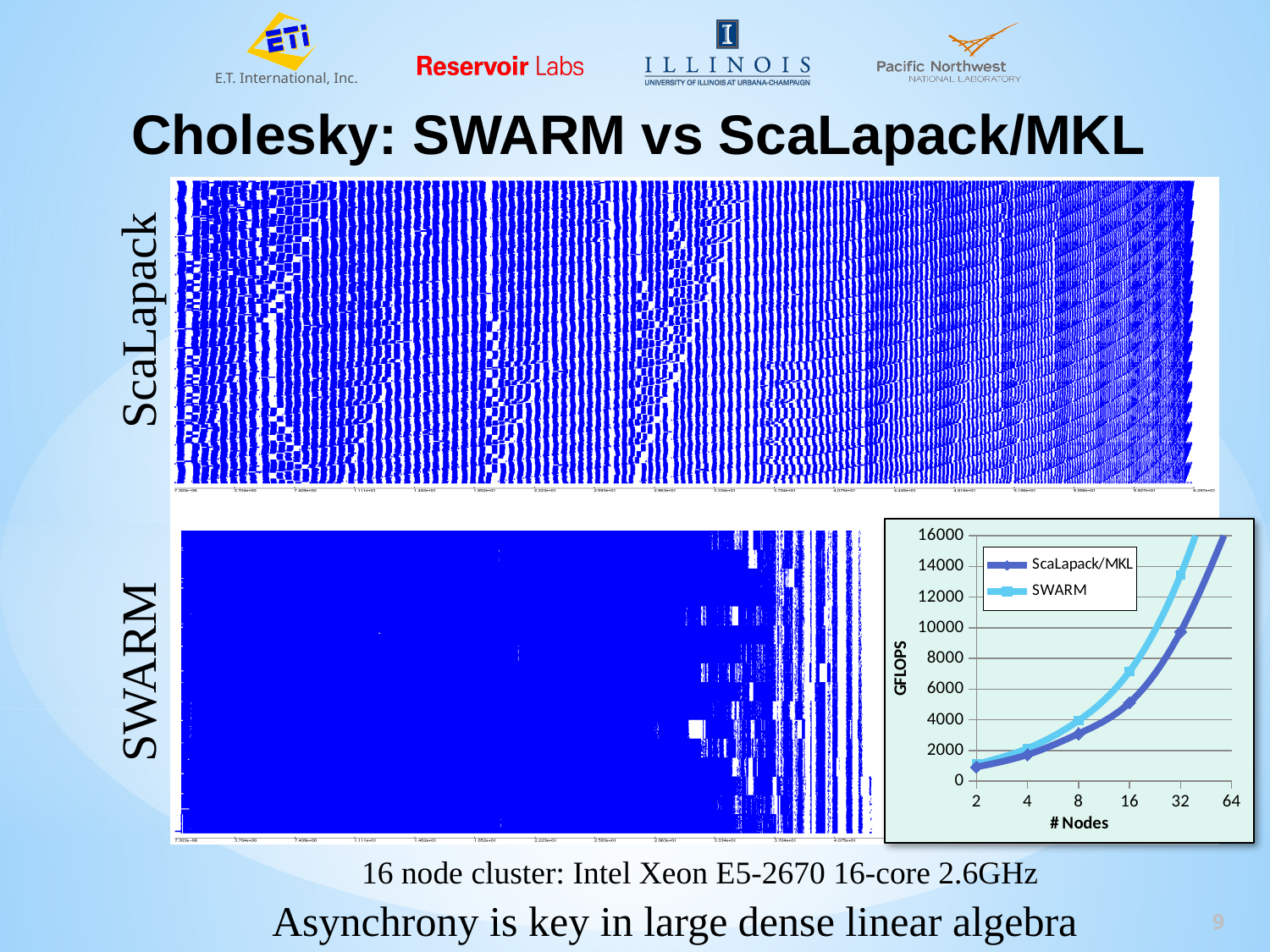
What is the label of the vertical axis of the line chart? GFLOPS In the GFLOPS chart, is the ScaLapack/MKL value at 32 nodes greater or less than 8000? greater How many node counts are marked on the x axis of the GFLOPS chart? 6 In the GFLOPS chart, do the values rise or fall as the number of nodes increases? rise In the GFLOPS chart, is the SWARM value at 2 nodes greater or less than 2000? less In the GFLOPS chart, which series is higher at 16 nodes, SWARM or ScaLapack/MKL? SWARM In the GFLOPS chart, is the ScaLapack/MKL value at 8 nodes greater or less than 4000? less Which two series are listed in the legend of the GFLOPS chart? ScaLapack/MKL and SWARM How many series does the legend of the GFLOPS chart list? 2 In the GFLOPS chart, which series is higher at 32 nodes, SWARM or ScaLapack/MKL? SWARM What kind of chart is the GFLOPS vs # Nodes chart on the slide? line chart